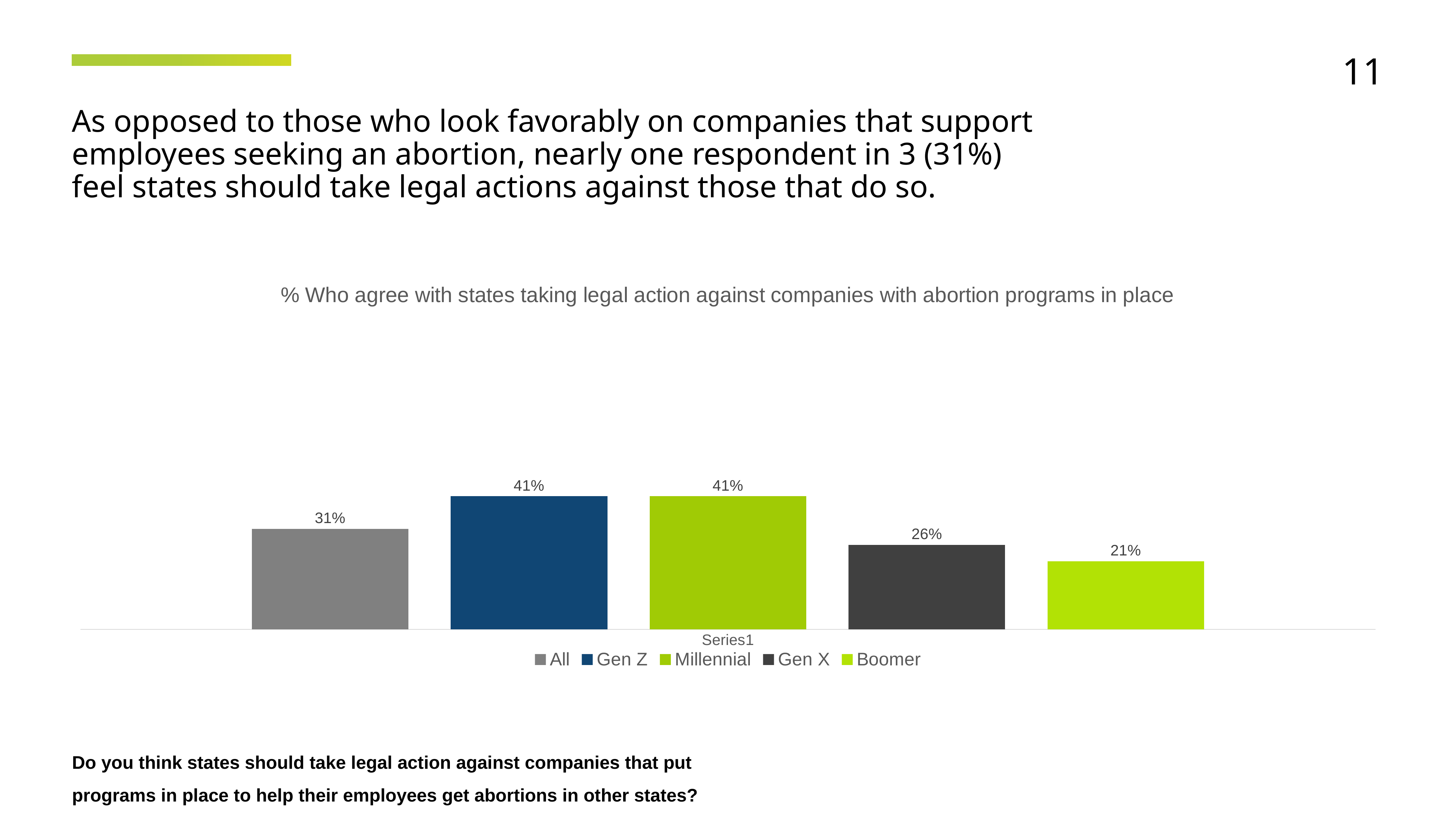
What is the value for Gen Z in the chart? 41% How many bars are plotted in the chart? 5 What is the difference between the values for Gen Z and Boomer? 20 percentage points What is the difference between the values for All and Gen X? 5 percentage points Which is larger, the value for All or the value for Gen X? All What is the value for All in the chart? 31% What kind of chart is shown on the slide? Bar chart What is the value for Boomer in the chart? 21% Which group has the lowest value in the chart? Boomer How many series does the legend list? 5 What is the value for Gen X in the chart? 26% What is the value for Millennial in the chart? 41%